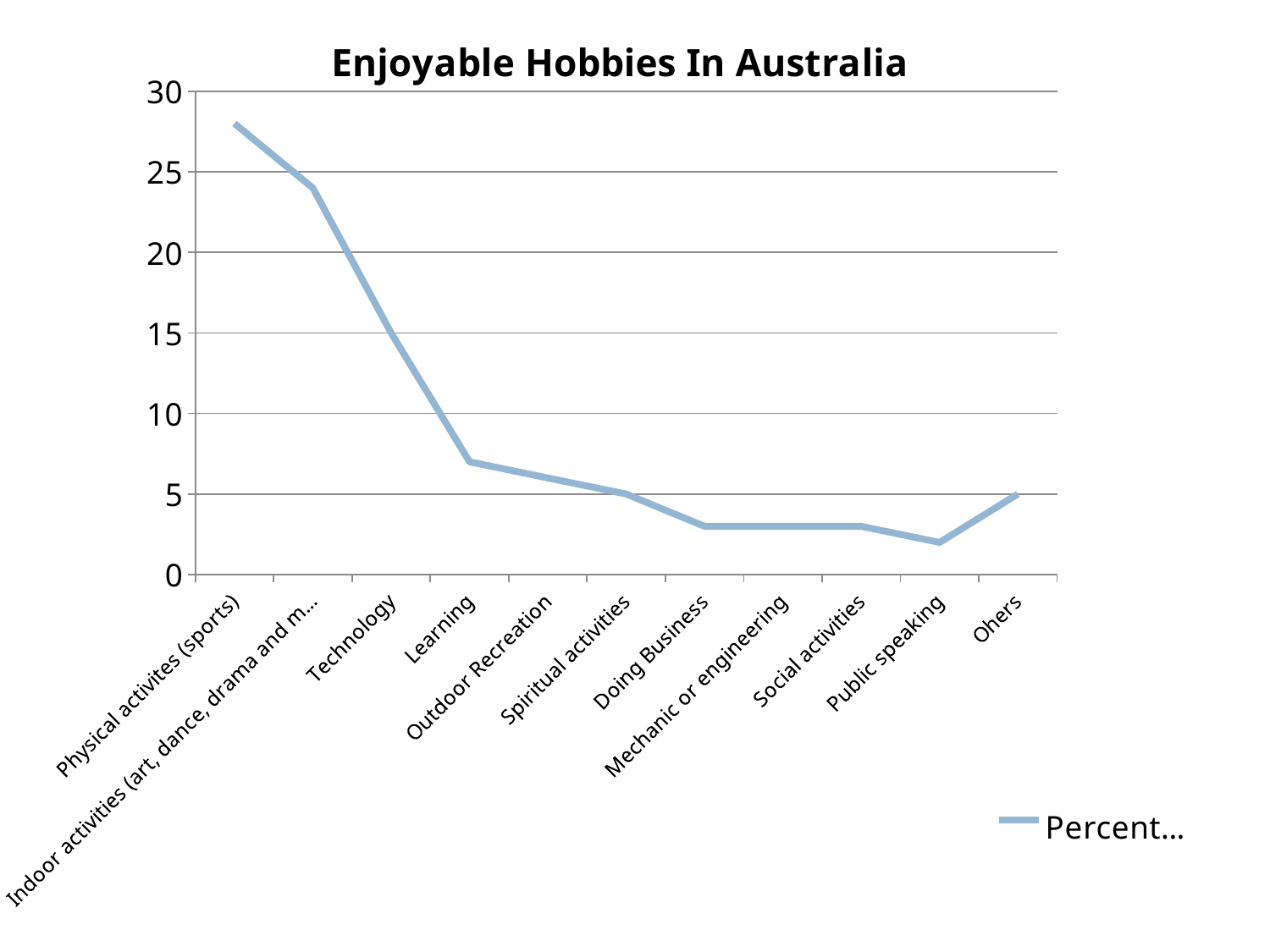
Which has a larger value, Technology or Learning? Technology How many hobby categories are plotted along the x axis? 11 What is the title of the chart? Enjoyable Hobbies In Australia How many series does the legend list? 1 Which hobby category has the lowest value? Public speaking Is the value for Doing Business greater or less than 5? less Is the value for Technology greater or less than 10? greater What type of chart is shown on the slide? line chart Do the values generally rise or fall moving from left to right along the x axis? fall Is the value for Learning greater or less than 10? less Which hobby category has the highest value? Physical activites (sports)